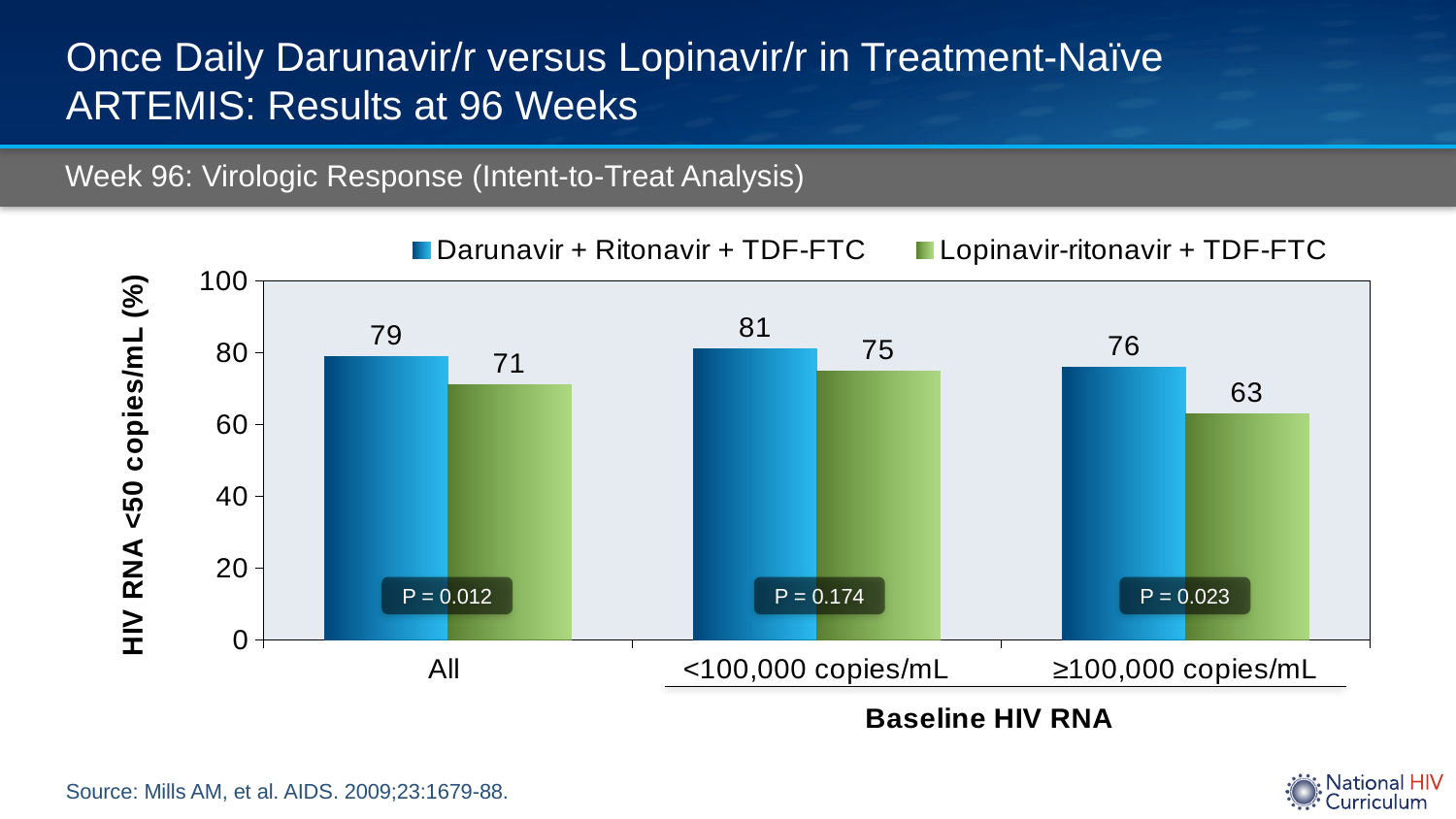
What is the value for Darunavir + Ritonavir + TDF-FTC in the All category? 79 What is the P value shown for the All category? P = 0.012 What is the difference between the Darunavir + Ritonavir + TDF-FTC and Lopinavir-ritonavir + TDF-FTC values in the ≥100,000 copies/mL category? 13 How many baseline HIV RNA categories are shown on the x axis? 3 Which series has the larger value in the <100,000 copies/mL category? Darunavir + Ritonavir + TDF-FTC What is the value for Lopinavir-ritonavir + TDF-FTC in the <100,000 copies/mL category? 75 Which baseline HIV RNA category has the lowest value for Lopinavir-ritonavir + TDF-FTC? ≥100,000 copies/mL How many series does the legend list? 2 What kind of chart is shown on the slide? Bar chart What is the value for Lopinavir-ritonavir + TDF-FTC in the ≥100,000 copies/mL category? 63 Which baseline HIV RNA category has the highest value for Darunavir + Ritonavir + TDF-FTC? <100,000 copies/mL What is the difference between the Darunavir + Ritonavir + TDF-FTC and Lopinavir-ritonavir + TDF-FTC values in the All category? 8